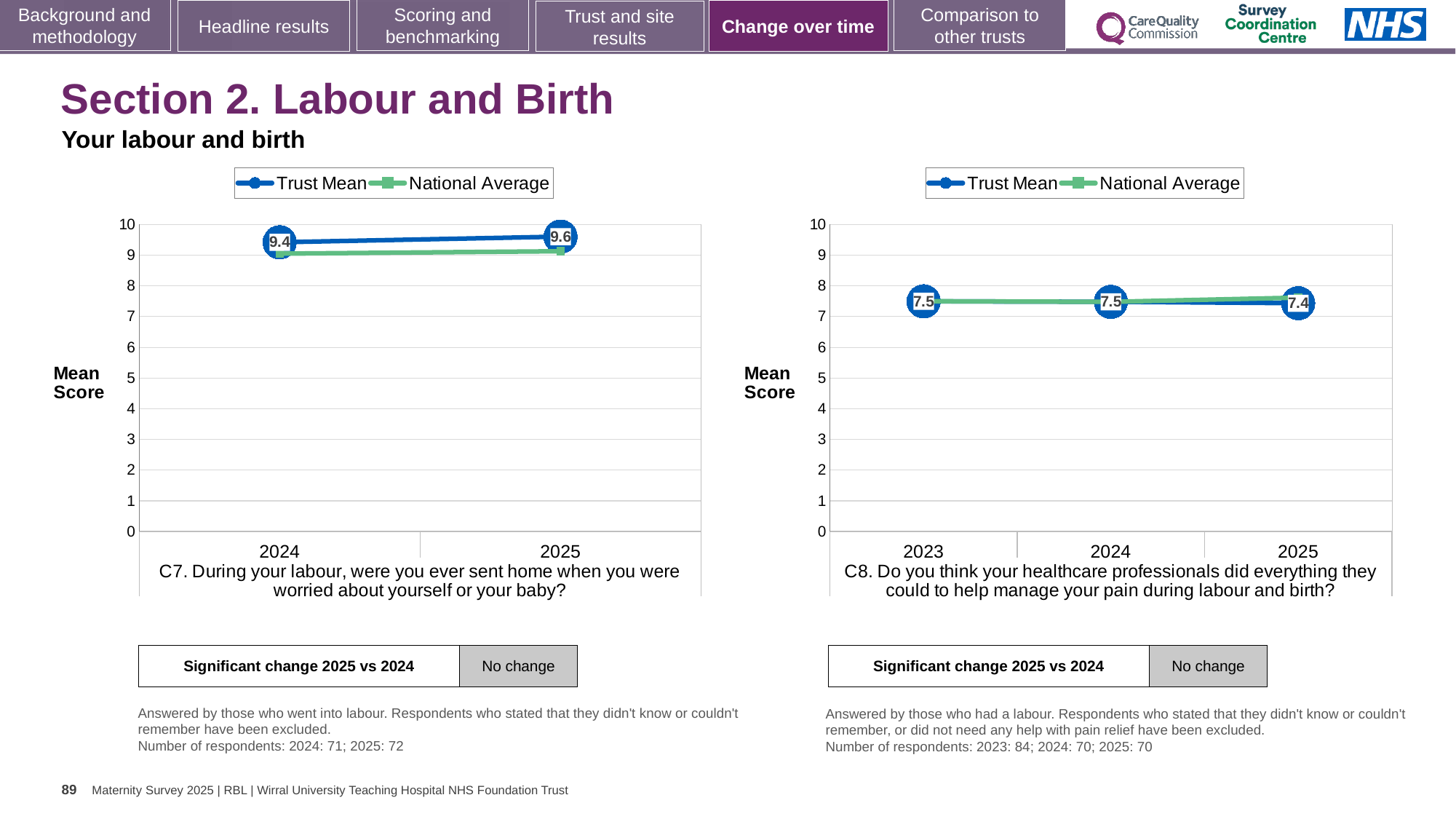
How many years are shown on the x axis of the C8 chart on the right? 3 In the C8 chart on the right, what is the Trust Mean for 2025? 7.4 In the C8 chart on the right, which year has the lowest Trust Mean? 2025 In the C7 chart on the left, is the Trust Mean higher in 2024 or 2025? 2025 In the C7 chart on the left, does the Trust Mean rise or fall from 2024 to 2025? Rise How many series does the legend of the C7 chart on the left list? 2 In the C7 chart on the left, by how much did the Trust Mean change from 2024 to 2025? 0.2 In the C7 chart on the left, is the National Average for 2024 greater or less than 8? greater In the C7 chart on the left, what is the Trust Mean for 2025? 9.6 What type of chart is the C8 chart on the right? Line chart In the C8 chart on the right, what is the Trust Mean for 2023? 7.5 In the C7 chart on the left, what is the Trust Mean for 2024? 9.4